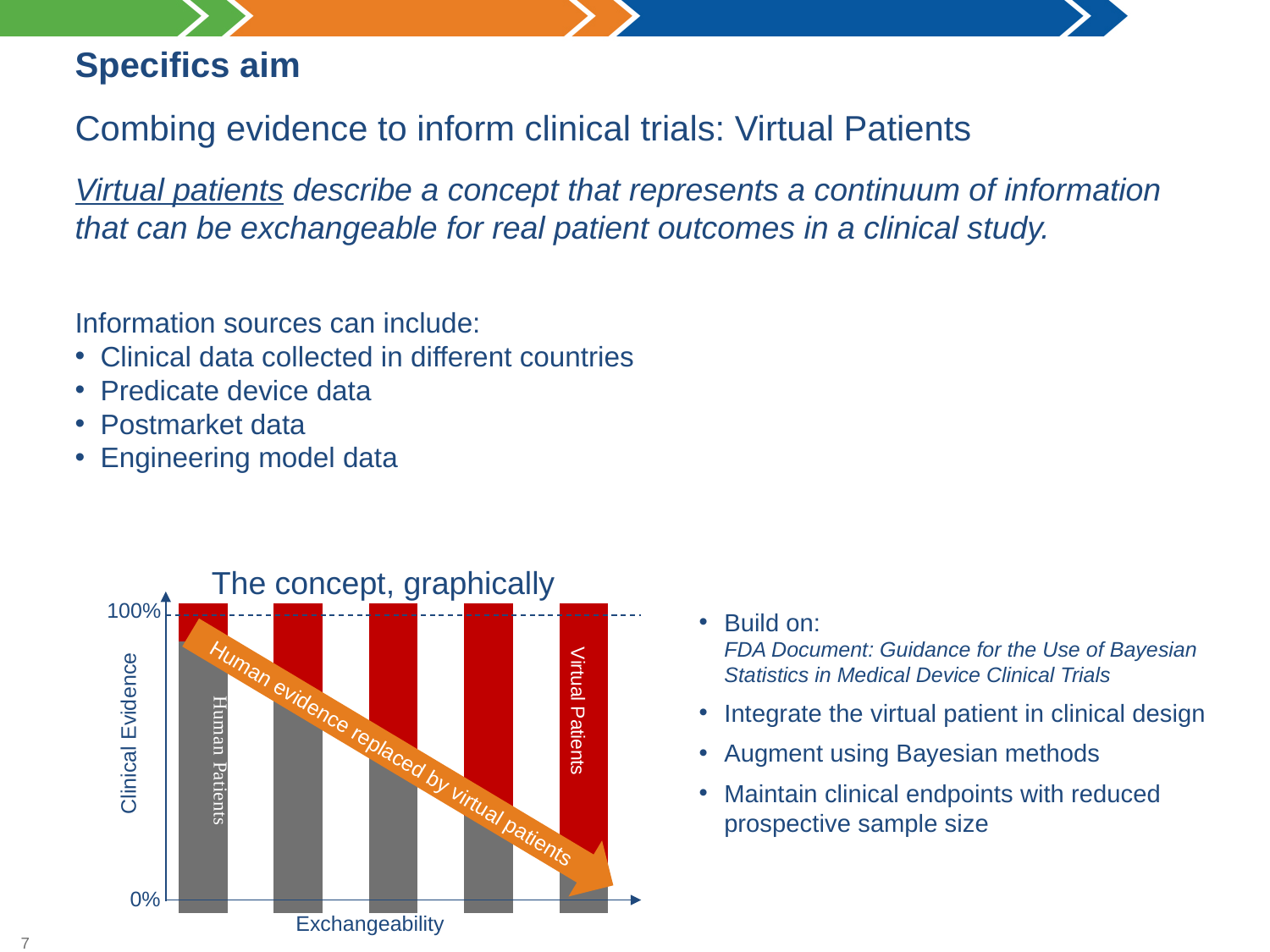
What is the title of the chart? The concept, graphically How many bars are plotted in the chart? 5 In the leftmost bar, which portion is larger: Human Patients or Virtual Patients? Human Patients What is the highest value shown on the vertical axis? 100% What is the label on the horizontal axis of the chart? Exchangeability Does the red "Virtual Patients" portion of the bars rise or fall from left to right along the x axis? Rise What is the lowest value shown on the vertical axis? 0% Does the gray "Human Patients" portion of the bars rise or fall from left to right along the x axis? Fall What kind of chart is shown under the heading "The concept, graphically"? Stacked bar chart What is the total height of each stacked bar in the chart? 100% What is the label on the vertical axis of the chart? Clinical Evidence In the rightmost bar, which portion is larger: Human Patients or Virtual Patients? Virtual Patients